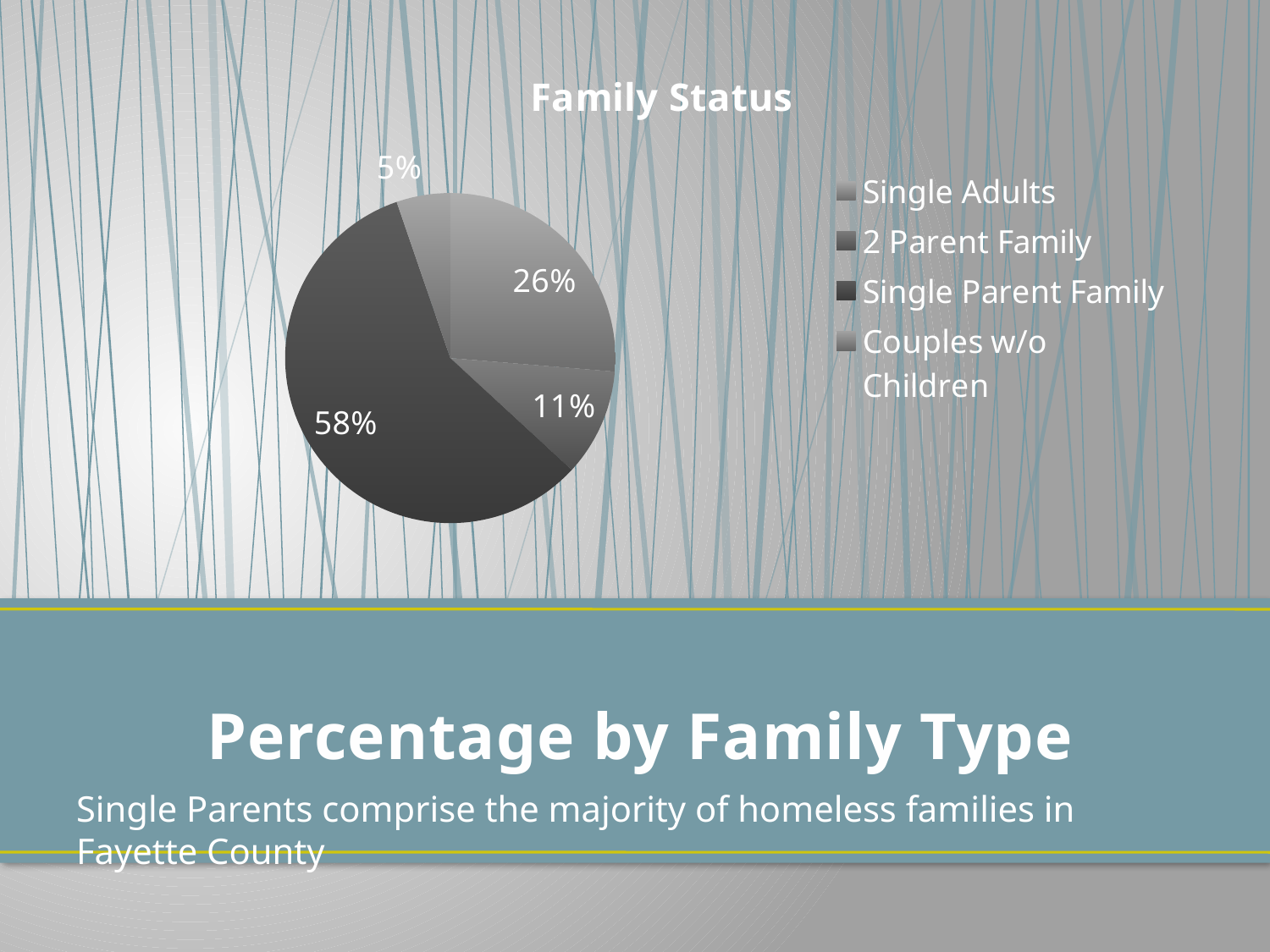
What is the combined share of Single Adults and 2 Parent Family? 37% What is the title of the chart? Family Status Which category has the largest share of the pie? Single Parent Family What is the difference in percentage points between Single Parent Family and Single Adults? 32 Which is larger, the share for Single Adults or the share for 2 Parent Family? Single Adults What percentage of the pie is Single Adults? 26% What percentage of the pie is Couples w/o Children? 5% How many categories does the legend list? 4 Which category has the smallest share of the pie? Couples w/o Children What percentage of the pie is Single Parent Family? 58% What percentage of the pie is 2 Parent Family? 11% What type of chart is shown on the slide? pie chart